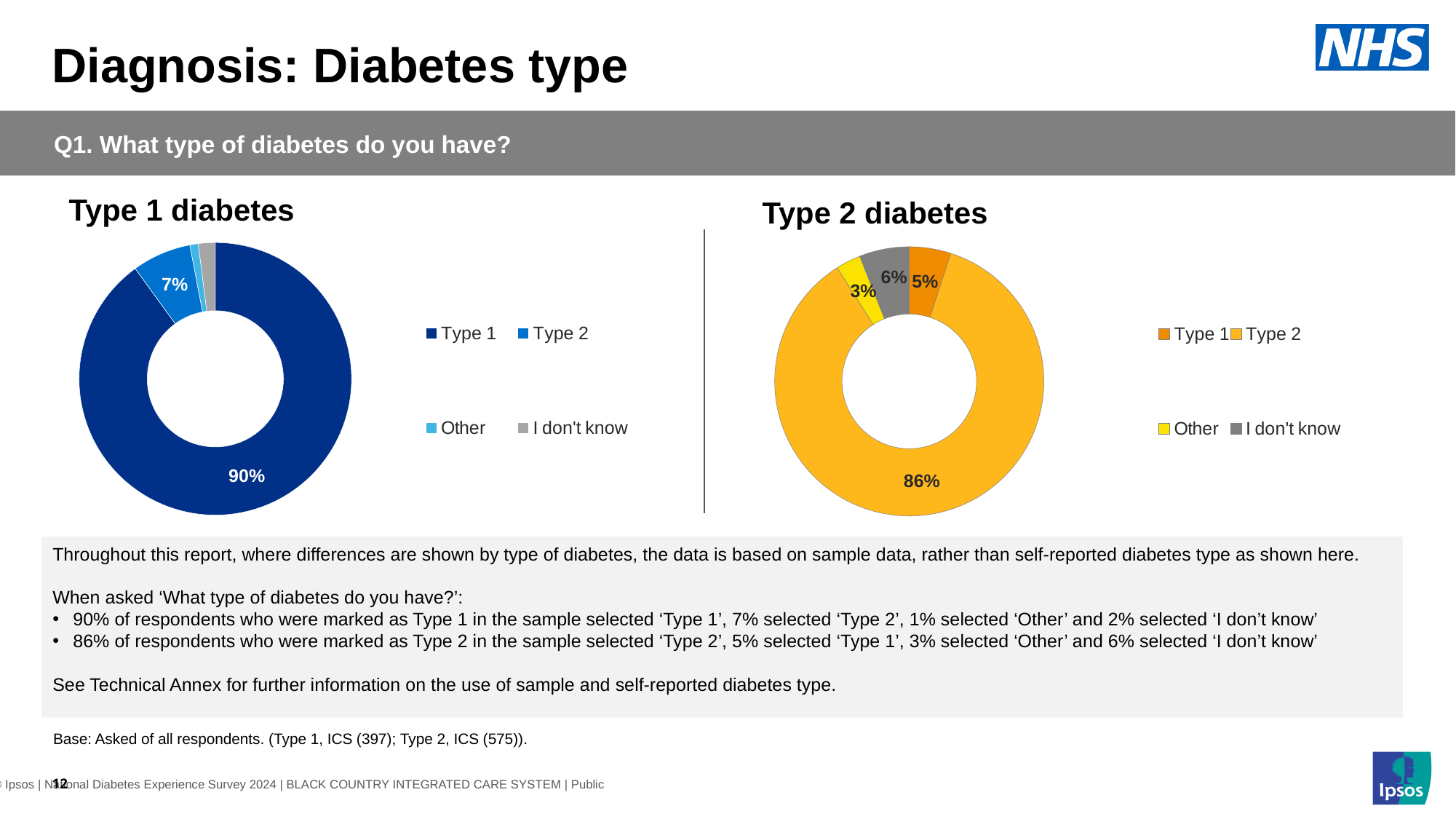
In the Type 2 diabetes chart, which is larger: the share for 'I don't know' or the share for 'Type 1'? I don't know In the Type 2 diabetes chart, what percentage of respondents selected 'Type 2'? 86% In the Type 2 diabetes chart, what percentage of respondents selected 'Other'? 3% In the Type 2 diabetes chart, how many percentage points larger is the 'Type 2' share than the 'Type 1' share? 81 percentage points In the Type 2 diabetes chart, what percentage of respondents selected 'Type 1'? 5% In the Type 2 diabetes chart, what percentage of respondents selected 'I don't know'? 6% In the Type 1 diabetes chart, what percentage of respondents selected 'Type 2'? 7% How many response categories does the legend of the Type 1 diabetes chart list? 4 In the Type 2 diabetes chart, which response has the smallest share? Other What kind of chart is used for the Type 1 diabetes data? Donut (pie) chart In the Type 1 diabetes chart, what percentage of respondents selected 'Type 1'? 90% In the Type 2 diabetes chart, which response has the largest share? Type 2